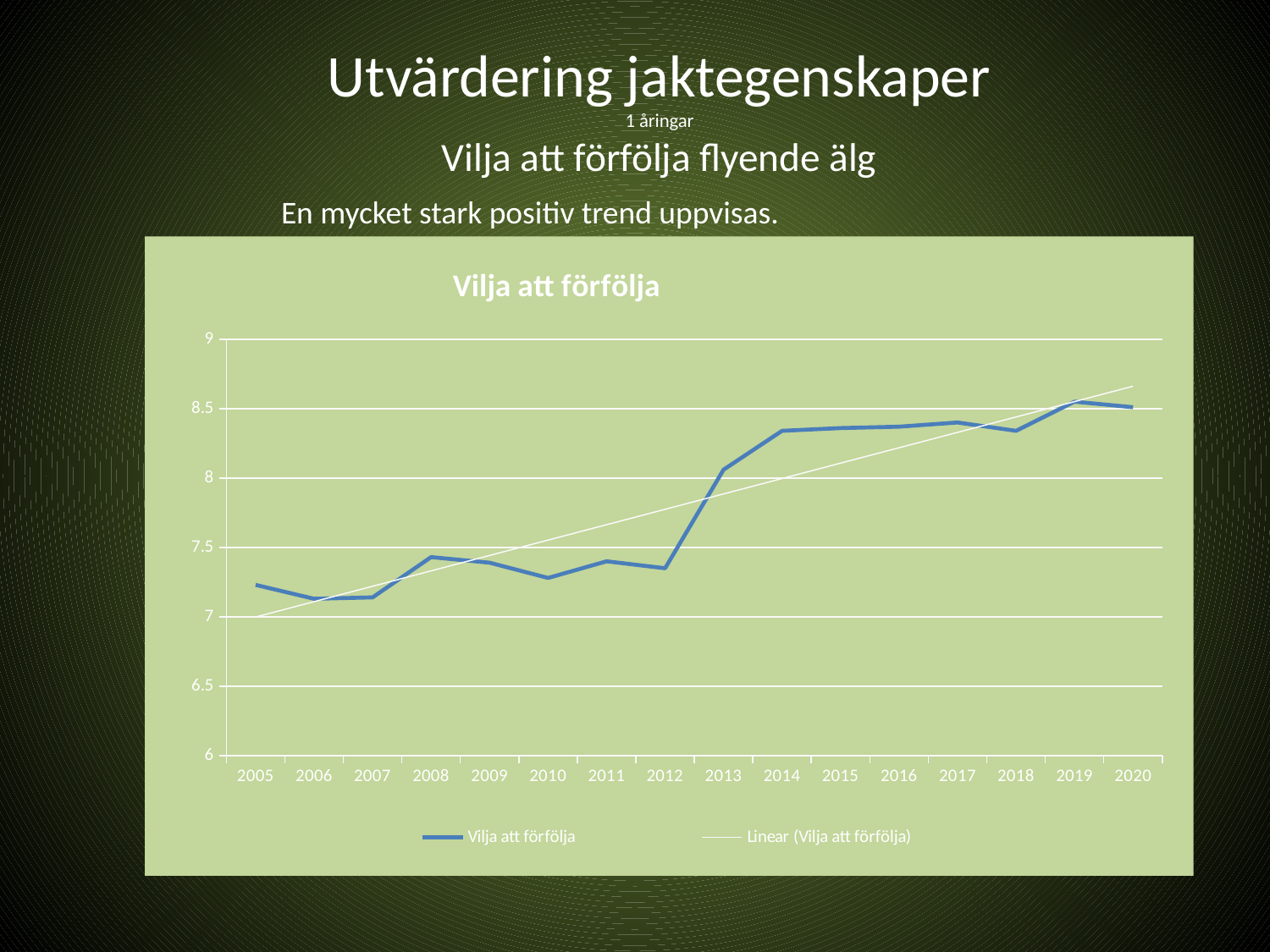
How many entries does the chart legend list? 2 What is the first year shown on the x axis of the chart? 2005 How many years are shown on the x axis of the chart? 16 What kind of chart is shown on the slide? Line chart Which year has the larger value for Vilja att förfölja, 2012 or 2013? 2013 Is the value for Vilja att förfölja in 2014 greater or less than 8? greater Is the value for Vilja att förfölja in 2005 greater or less than 7.5? less Is the value for Vilja att förfölja in 2017 greater or less than 8? greater Which year has the larger value for Vilja att förfölja, 2005 or 2014? 2014 Does the value for Vilja att förfölja generally rise or fall from 2005 to 2020? Rise What is the title of the chart? Vilja att förfölja